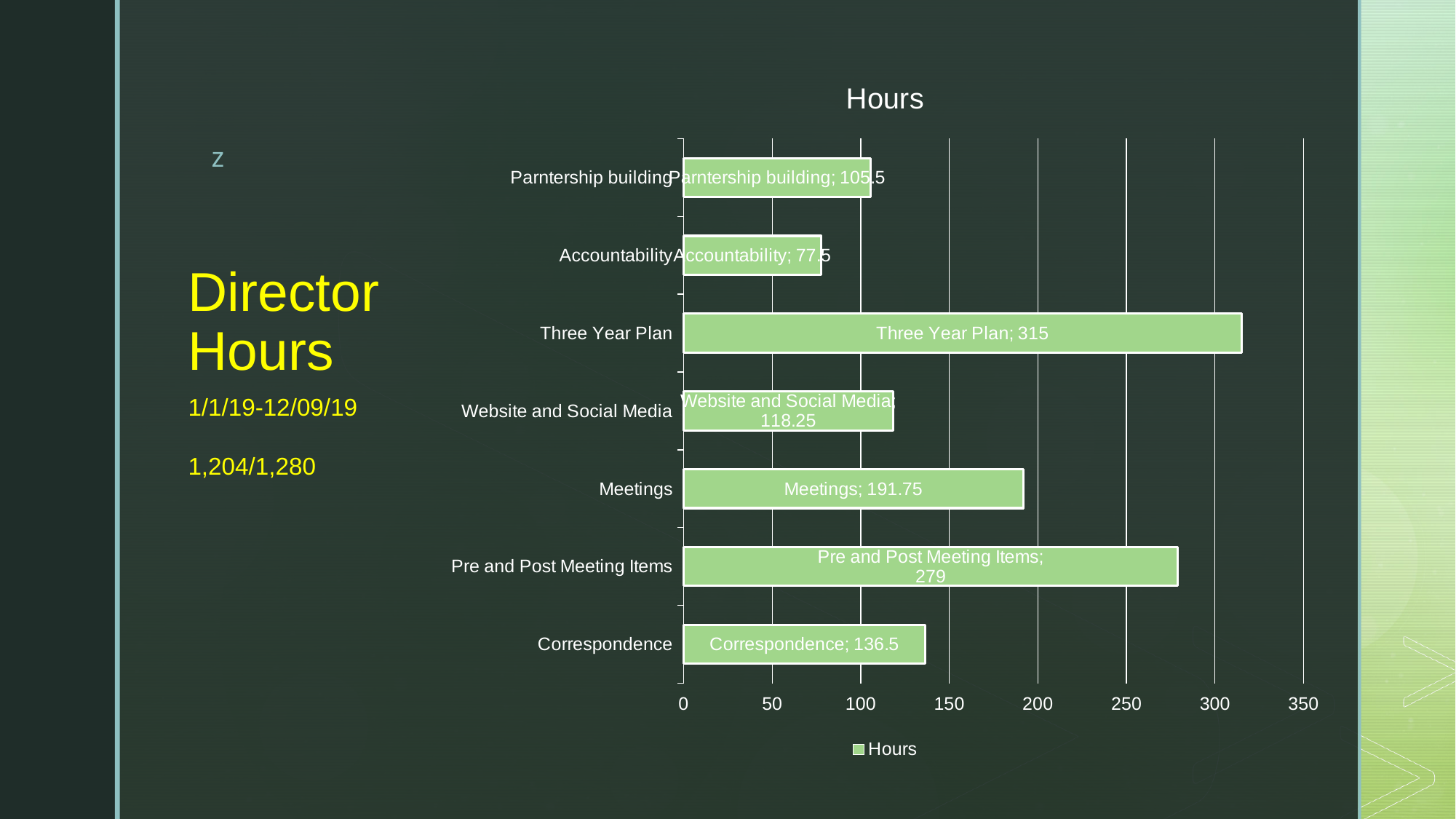
Which category has the lowest value? Accountability Which category has the highest value? Three Year Plan What is the value for Three Year Plan? 315 How many categories are shown in the chart? 7 What is the value for Website and Social Media? 118.25 What is the difference between Three Year Plan and Pre and Post Meeting Items? 36 What is the title of the chart? Hours Is the value for Pre and Post Meeting Items greater or less than 250? greater What is the value for Meetings? 191.75 What kind of chart is shown? bar chart Which is larger, Meetings or Correspondence? Meetings What is the value for Correspondence? 136.5